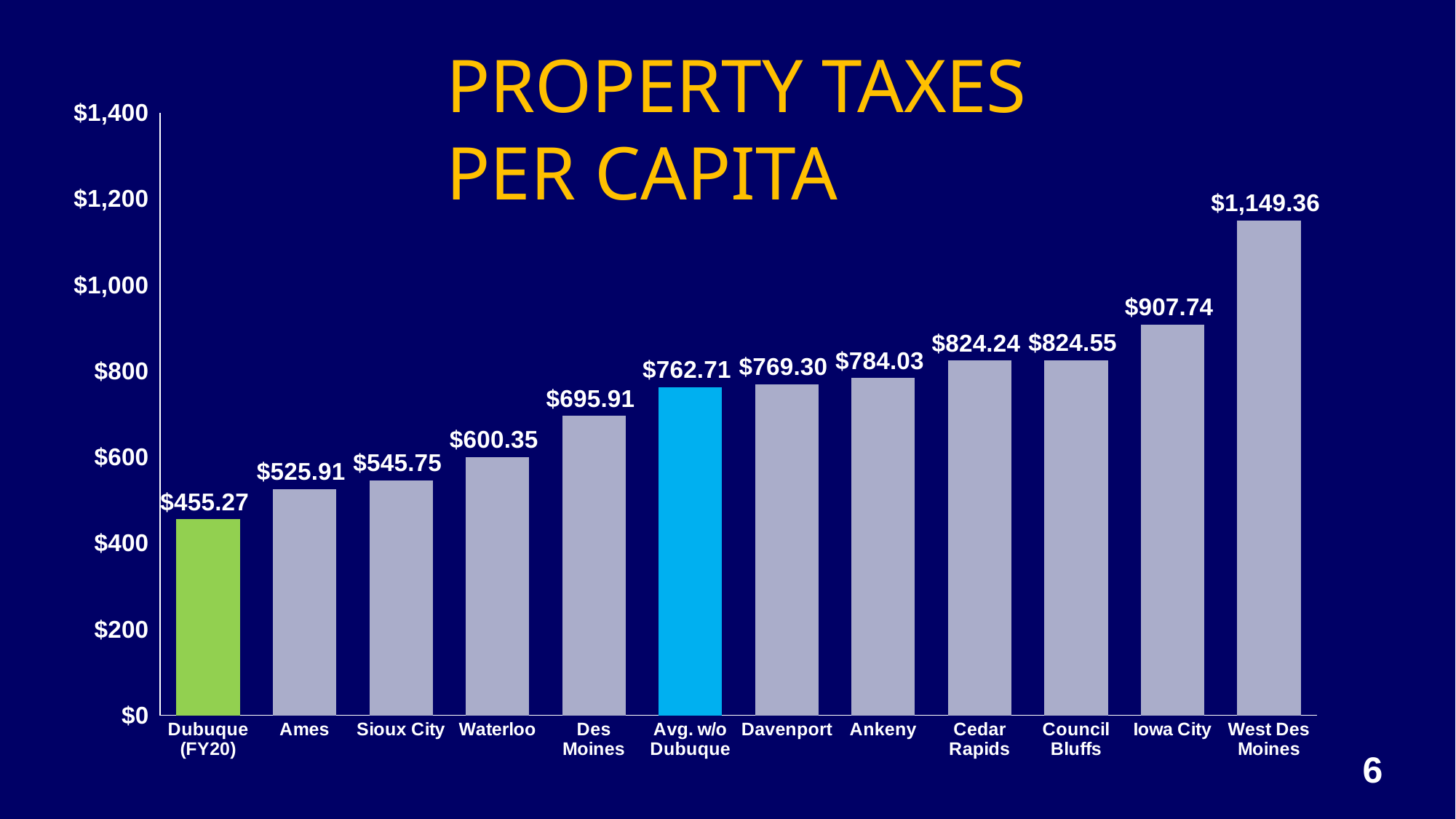
Which is larger, the value for Waterloo or the value for Des Moines? Des Moines What is the property tax per capita value for Dubuque (FY20)? $455.27 What is the difference between the values for Iowa City and Ankeny? $123.71 What is the difference between the values for West Des Moines and Dubuque (FY20)? $694.09 What is the value shown for Avg. w/o Dubuque? $762.71 Which category has the lowest property taxes per capita? Dubuque (FY20) Which category has the highest property taxes per capita? West Des Moines What is the value shown for Iowa City? $907.74 Is the value for Davenport greater or less than $800? less What kind of chart is shown on the slide? bar chart How many categories are shown on the x axis? 12 What is the title of the chart? PROPERTY TAXES PER CAPITA